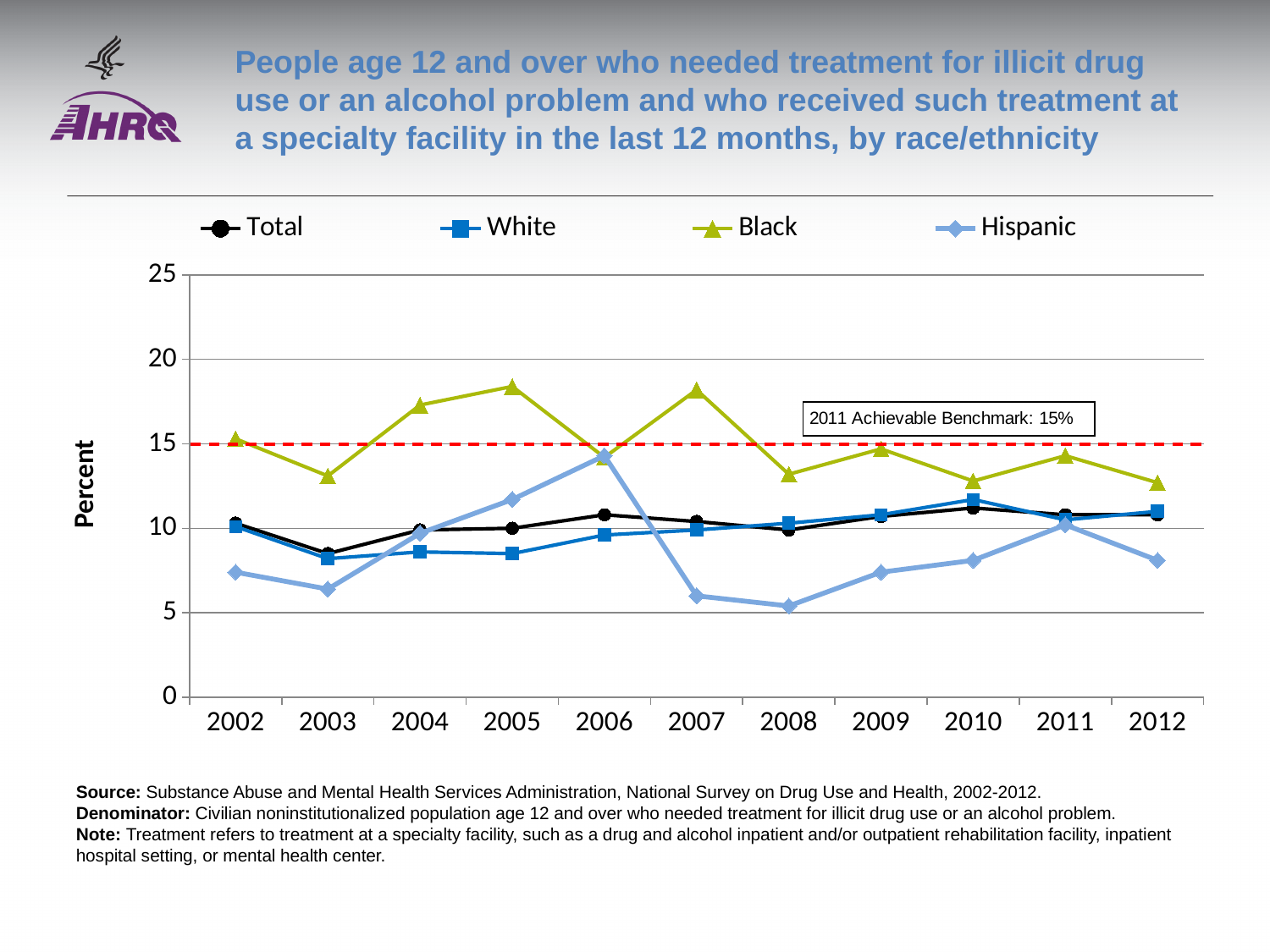
In which year does the Hispanic series reach its highest value? 2006 Is the value for Hispanic in 2008 greater or less than 10? less How many series does the legend list? 4 Is the value for Black in 2003 greater or less than 15? less In 2002, which is larger: the value for Black or the value for Hispanic? Black What kind of chart is shown on the slide? Line chart Is the value for Total in 2003 greater or less than 10? less How many years are plotted along the x axis? 11 Which series has the lowest value in 2008? Hispanic What value does the dashed red line labeled 2011 Achievable Benchmark represent? 15% Does the Hispanic series rise or fall from 2003 to 2006? Rise